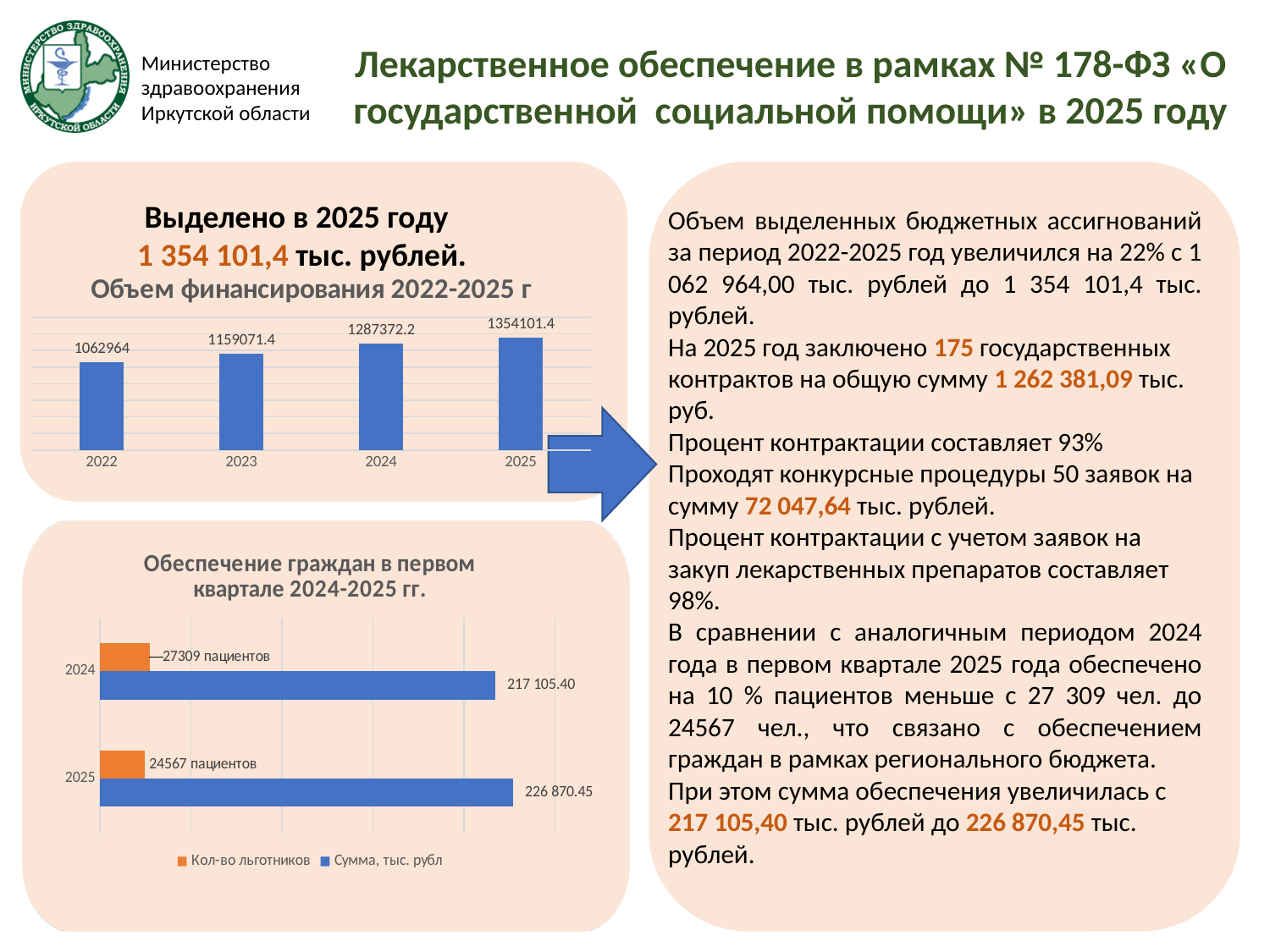
How many series does the legend of the chart 'Обеспечение граждан в первом квартале 2024-2025 гг.' list? 2 In the chart 'Объем финансирования 2022-2025 г', what is the value for 2024? 1287372.2 What type of chart is 'Объем финансирования 2022-2025 г'? bar chart In the chart 'Обеспечение граждан в первом квартале 2024-2025 гг.', which year has the larger 'Сумма, тыс. рубл' value, 2024 or 2025? 2025 In the chart 'Объем финансирования 2022-2025 г', do the values rise or fall from 2022 to 2025? rise In the chart 'Обеспечение граждан в первом квартале 2024-2025 гг.', what is the value of 'Кол-во льготников' for 2024? 27309 пациентов In the chart 'Объем финансирования 2022-2025 г', what is the value for 2022? 1062964 In the chart 'Объем финансирования 2022-2025 г', what is the difference between the values for 2025 and 2024? 66729.2 In the chart 'Объем финансирования 2022-2025 г', which year has the lowest value? 2022 In the chart 'Объем финансирования 2022-2025 г', how many years are shown? 4 In the chart 'Объем финансирования 2022-2025 г', which year has the highest value? 2025 In the chart 'Обеспечение граждан в первом квартале 2024-2025 гг.', what is the value of 'Сумма, тыс. рубл' for 2025? 226 870.45